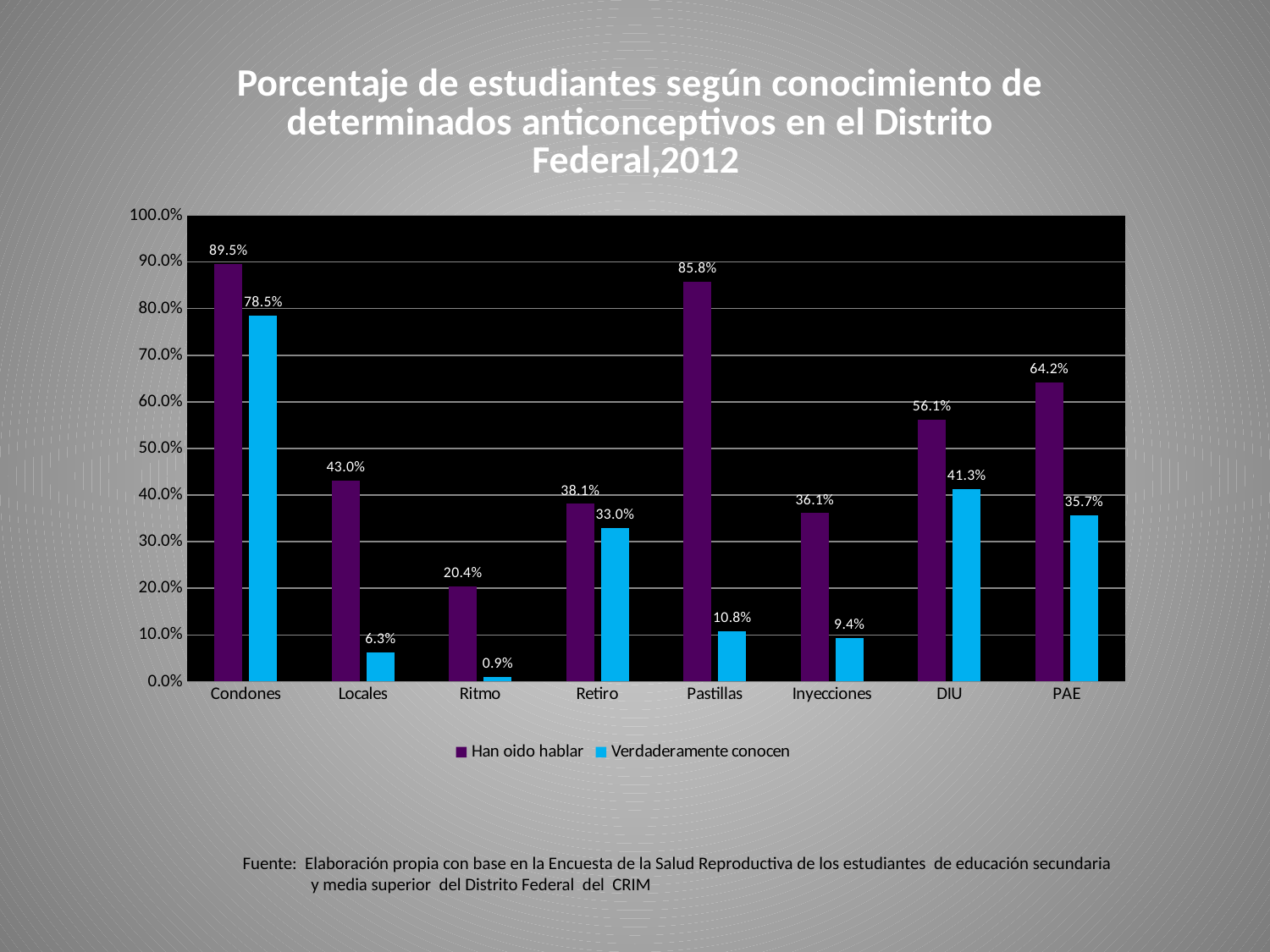
What is the value of "Verdaderamente conocen" for DIU? 41.3% Is the value of "Han oido hablar" for DIU greater or less than 50.0%? greater What kind of chart is shown on the slide? Bar chart What is the value of "Han oido hablar" for Pastillas? 85.8% How many categories are shown on the x axis? 8 What is the difference between "Han oido hablar" and "Verdaderamente conocen" for Pastillas? 75.0% How many series does the legend list? 2 Which category has the highest value for "Han oido hablar"? Condones Which category has the lowest value for "Verdaderamente conocen"? Ritmo What is the value of "Verdaderamente conocen" for Ritmo? 0.9% Which is larger: "Verdaderamente conocen" for Retiro or for PAE? PAE Which series is shown in purple? Han oido hablar